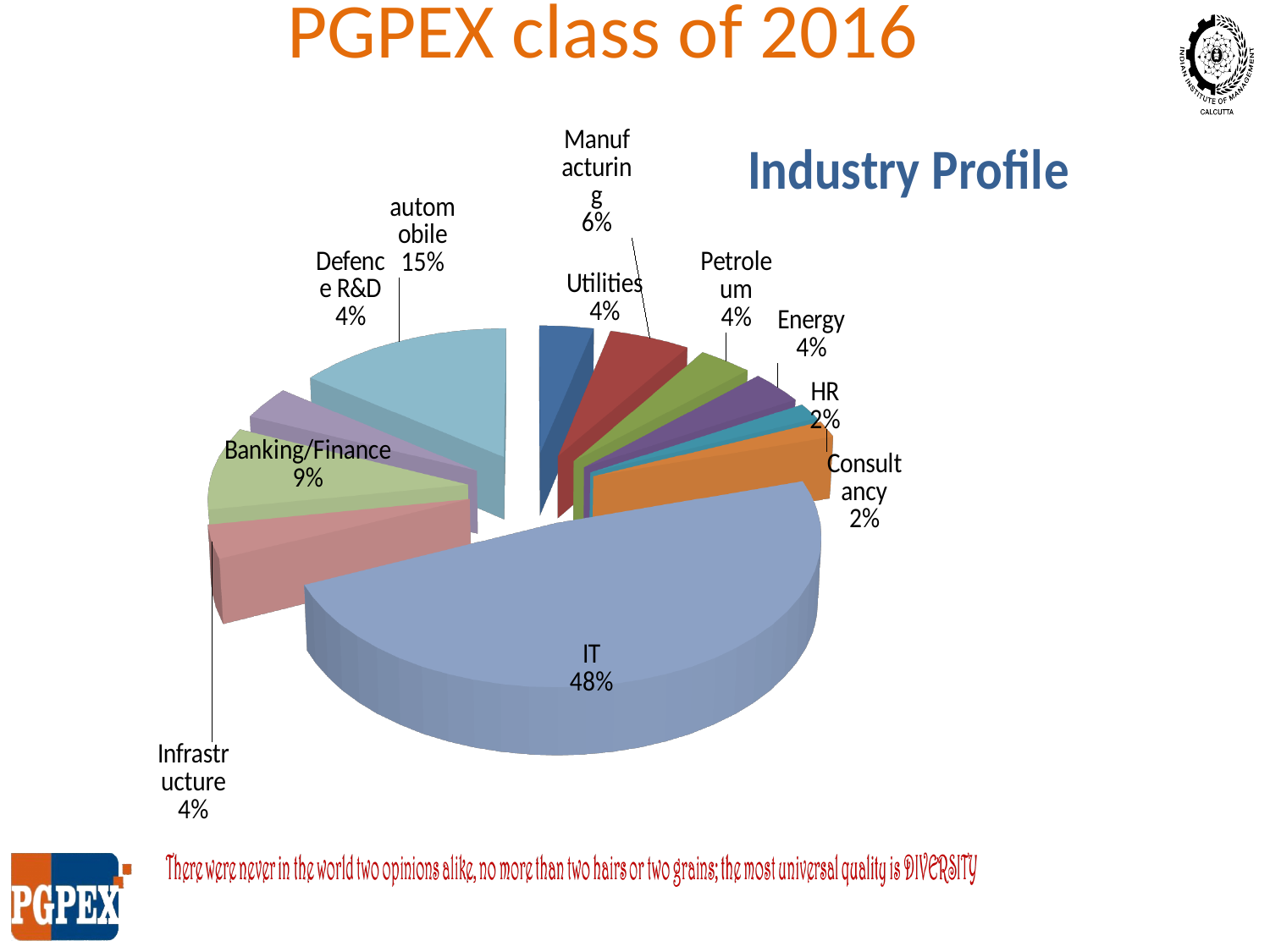
Which has a larger share, Banking/Finance or Manufacturing? Banking/Finance What is the title of the chart? Industry Profile What percentage is shown for automobile? 15% Which industry has the largest share of the pie? IT How many slices does the pie chart have? 11 What percentage is shown for Manufacturing? 6% What percentage is shown for Consultancy? 2% What is the difference in percentage points between IT and automobile? 33 What percentage is shown for Banking/Finance? 9% What kind of chart is shown on the slide? Pie chart What is the difference in percentage points between automobile and Banking/Finance? 6 What share of the pie does IT account for? 48%